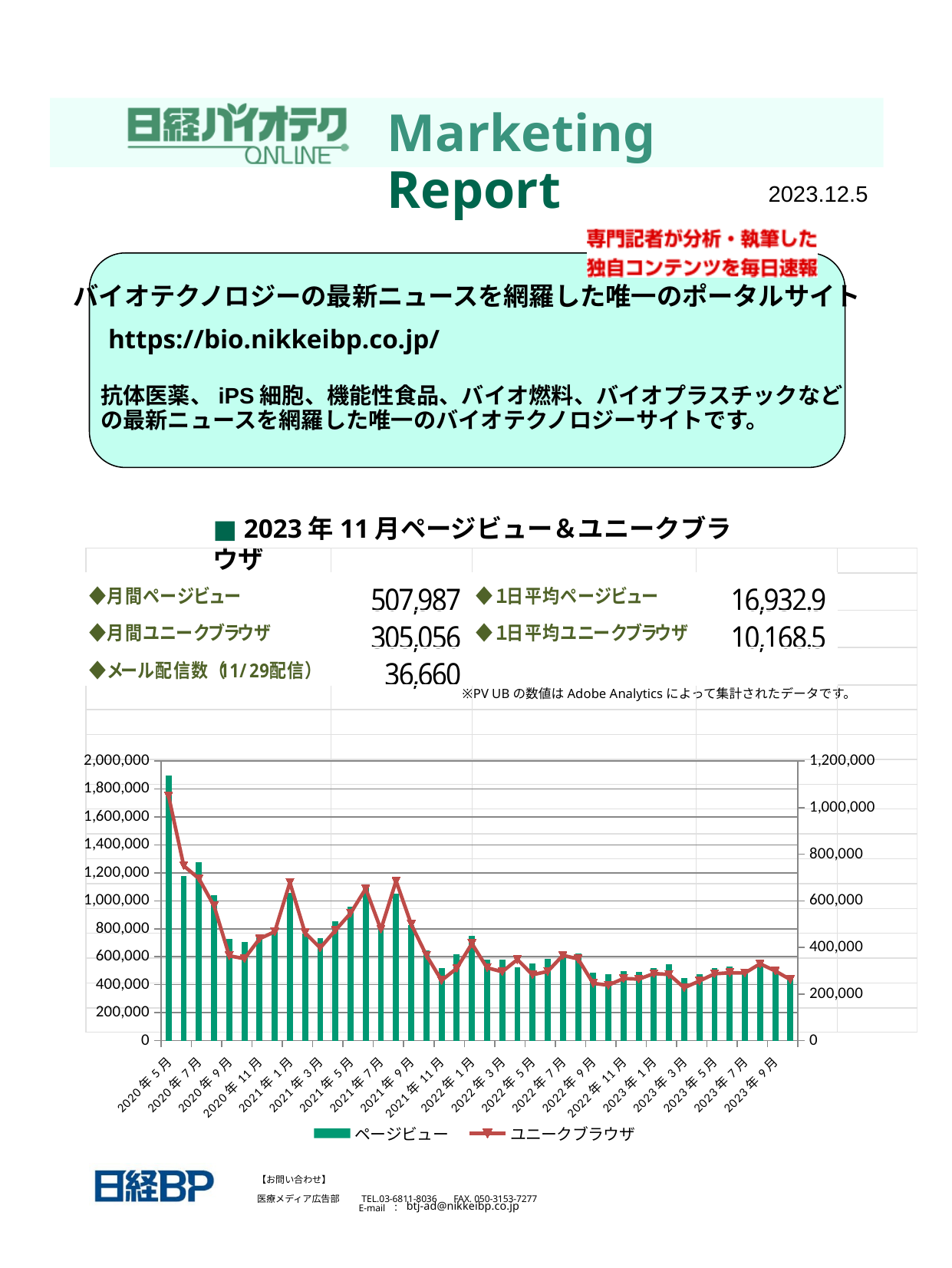
Is the page view (ページビュー) value for 2023年9月 greater or less than 600,000? less Is the unique browser (ユニークブラウザ) value for 2020年5月 greater or less than 1,000,000 on the right axis? greater What kind of chart is shown on the slide? A combined bar and line chart Overall, do page views (ページビュー) rise or fall from 2020年5月 to 2023年9月? fall Is the unique browser (ユニークブラウザ) value for 2021年1月 greater or less than 600,000 on the right axis? greater Which series is drawn as bars in the chart? ページビュー What is the maximum value shown on the left vertical axis of the chart? 2,000,000 How many series does the chart legend list? 2 Which month has the larger page view (ページビュー) bar, 2020年5月 or 2023年9月? 2020年5月 What are the two series named in the chart legend? ページビュー and ユニークブラウザ Which month has the highest page view (ページビュー) bar? 2020年5月